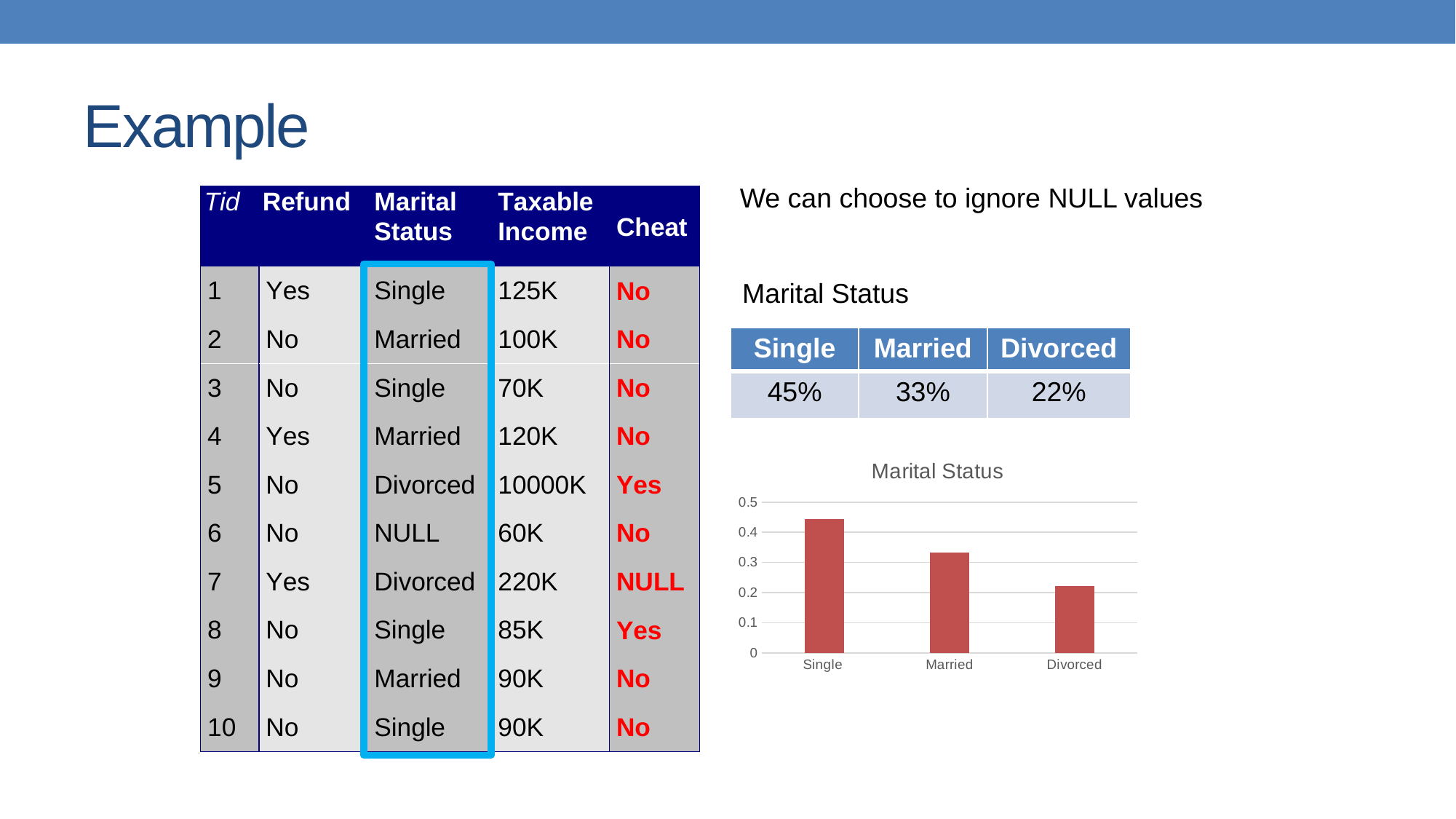
Which category has the lowest bar in the Marital Status chart? Divorced In the Marital Status chart, is the value for Married greater or less than 0.4? less Do the bar values rise or fall from left to right across the Marital Status chart? fall How many categories are shown on the x axis of the Marital Status chart? 3 What is the highest tick value shown on the y axis of the Marital Status chart? 0.5 What kind of chart is shown on the slide? bar chart Which category has the highest bar in the Marital Status chart? Single In the Marital Status chart, is the value for Divorced greater or less than 0.3? less What is the title of the chart on the slide? Marital Status In the Marital Status chart, is the value for Single greater or less than 0.4? greater In the Marital Status chart, is the bar for Married larger or smaller than the bar for Divorced? larger